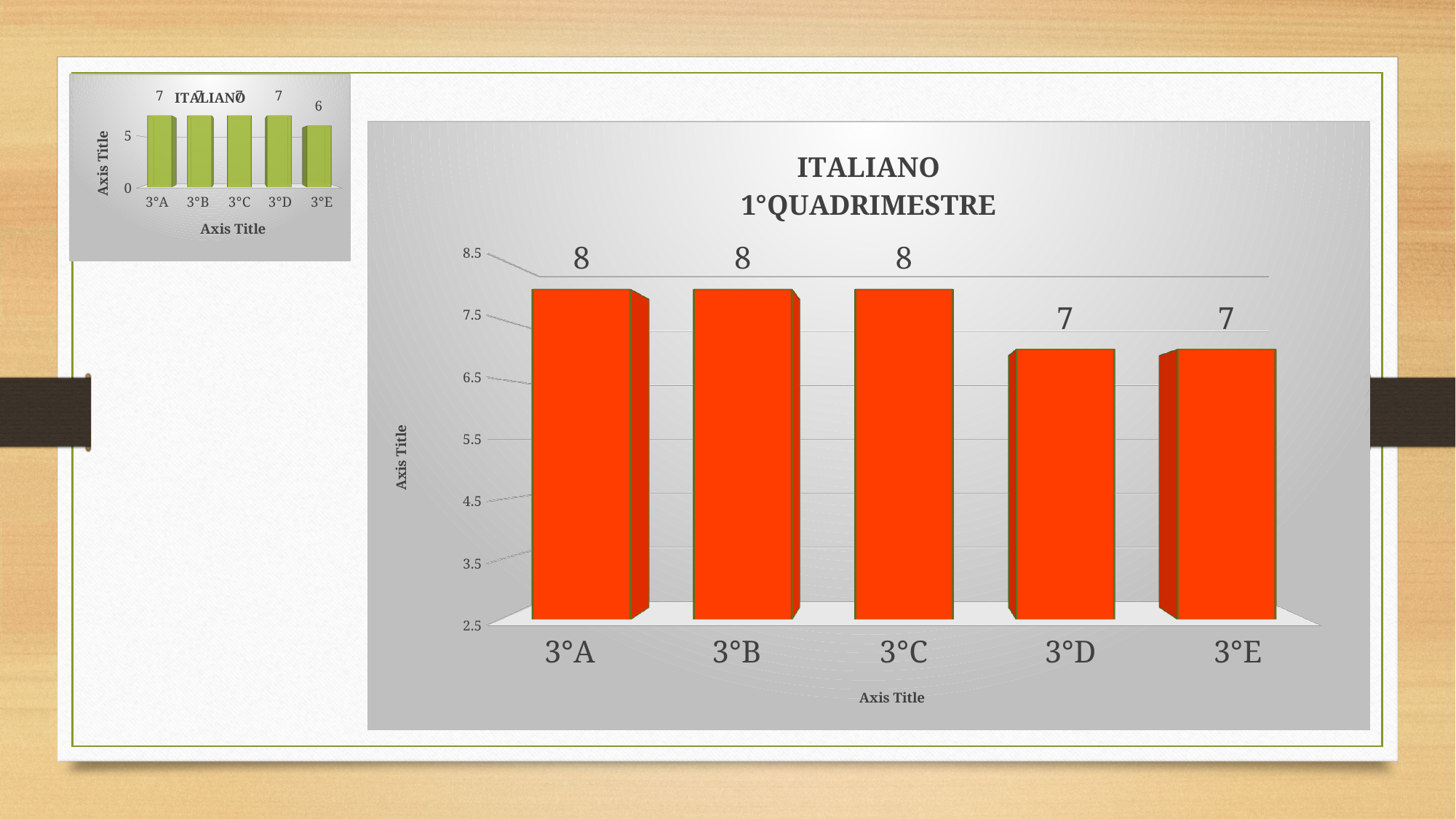
In the large chart titled ITALIANO 1°QUADRIMESTRE, how many categories are shown on the x axis? 5 What kind of chart is the large chart titled ITALIANO 1°QUADRIMESTRE? bar chart In the small chart at the top left of the slide, what colour are the bars? green In the large chart titled ITALIANO 1°QUADRIMESTRE, is the value for 3°D greater or less than 7.5? less In the large chart titled ITALIANO 1°QUADRIMESTRE, what is the value for 3°A? 8 In the small chart at the top left of the slide, which category has the lowest value? 3°E In the large chart titled ITALIANO 1°QUADRIMESTRE, what is the title of the chart? ITALIANO 1°QUADRIMESTRE In the large chart titled ITALIANO 1°QUADRIMESTRE, what is the value for 3°D? 7 In the large chart titled ITALIANO 1°QUADRIMESTRE, what is the value for 3°E? 7 In the large chart titled ITALIANO 1°QUADRIMESTRE, what is the difference between the values for 3°C and 3°D? 1 In the large chart titled ITALIANO 1°QUADRIMESTRE, which is larger, the value for 3°B or the value for 3°E? 3°B In the small chart at the top left of the slide, what is the value for 3°E? 6